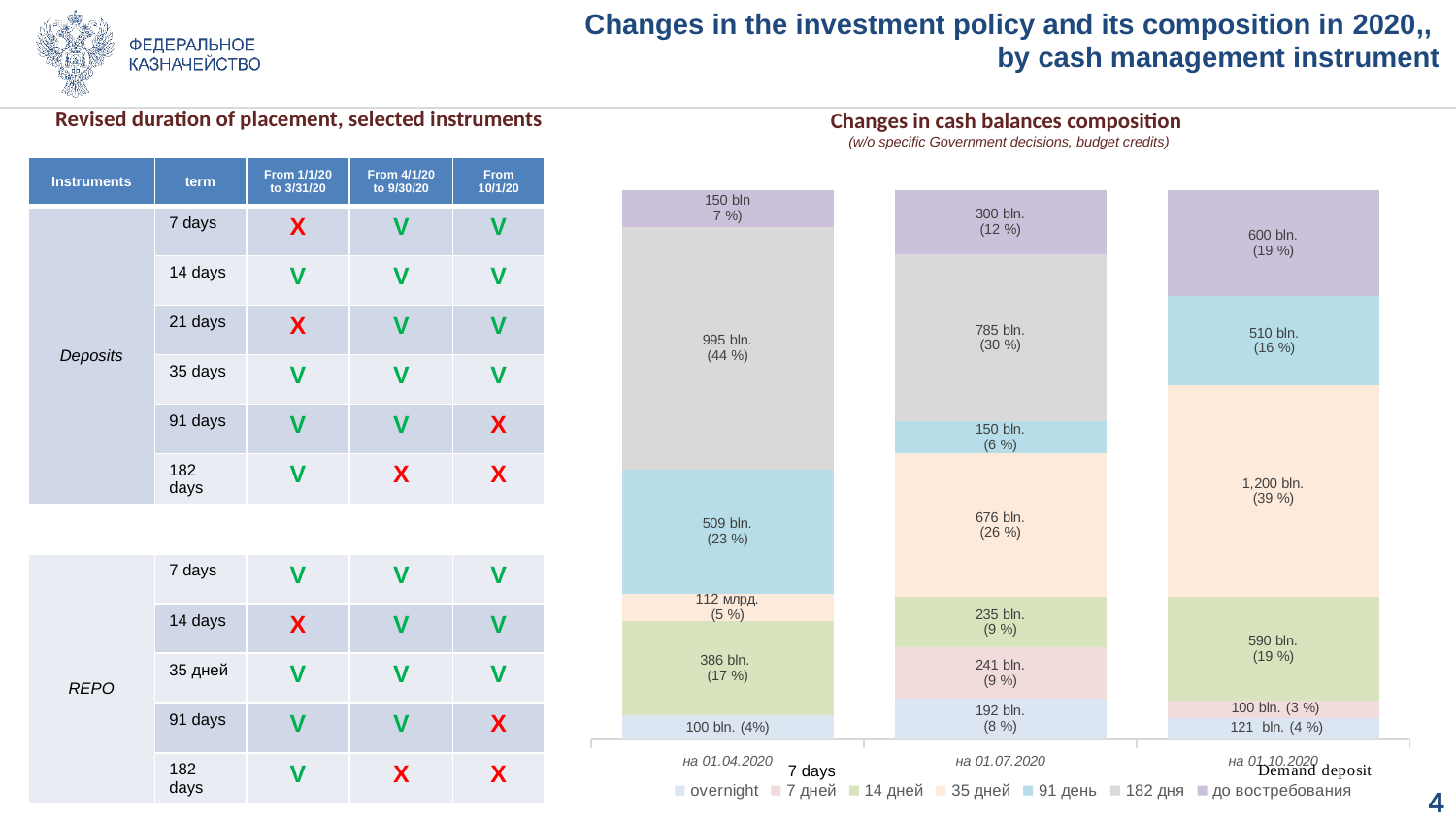
In the 'Changes in cash balances composition' chart, what is the value of the overnight segment in the bar for на 01.07.2020? 192 bln. (8 %) How many series does the legend of the 'Changes in cash balances composition' chart list? 7 In the 'Changes in cash balances composition' chart, what is the total of the bar for на 01.10.2020 in bln? 3,121 bln In the 'Changes in cash balances composition' chart, what is the difference in bln between the 182 дня segment on 01.04.2020 (995 bln) and on 01.07.2020 (785 bln)? 210 bln What type of chart is shown under the title 'Changes in cash balances composition'? Stacked bar chart How many bars (dates) does the 'Changes in cash balances composition' chart show? 3 In the 'Changes in cash balances composition' chart, what is the smallest segment in the bar for на 01.10.2020? 100 bln. (3 %) In the 'Changes in cash balances composition' chart, what is the value of the 35 дней segment in the bar for на 01.10.2020? 1,200 bln. (39 %) In the 'Changes in cash balances composition' chart, what is the value of the 182 дня segment in the bar for на 01.07.2020? 785 bln. (30 %) In the 'Changes in cash balances composition' chart, what is the value of the largest segment in the bar for на 01.04.2020? 995 bln. (44 %) In the 'Changes in cash balances composition' chart, what share of the bar for на 01.07.2020 does the 35 дней segment represent? 26 % In the 'Changes in cash balances composition' chart, which is larger: the 91 день segment on 01.04.2020 or the 91 день segment on 01.07.2020? 01.04.2020 (509 bln)